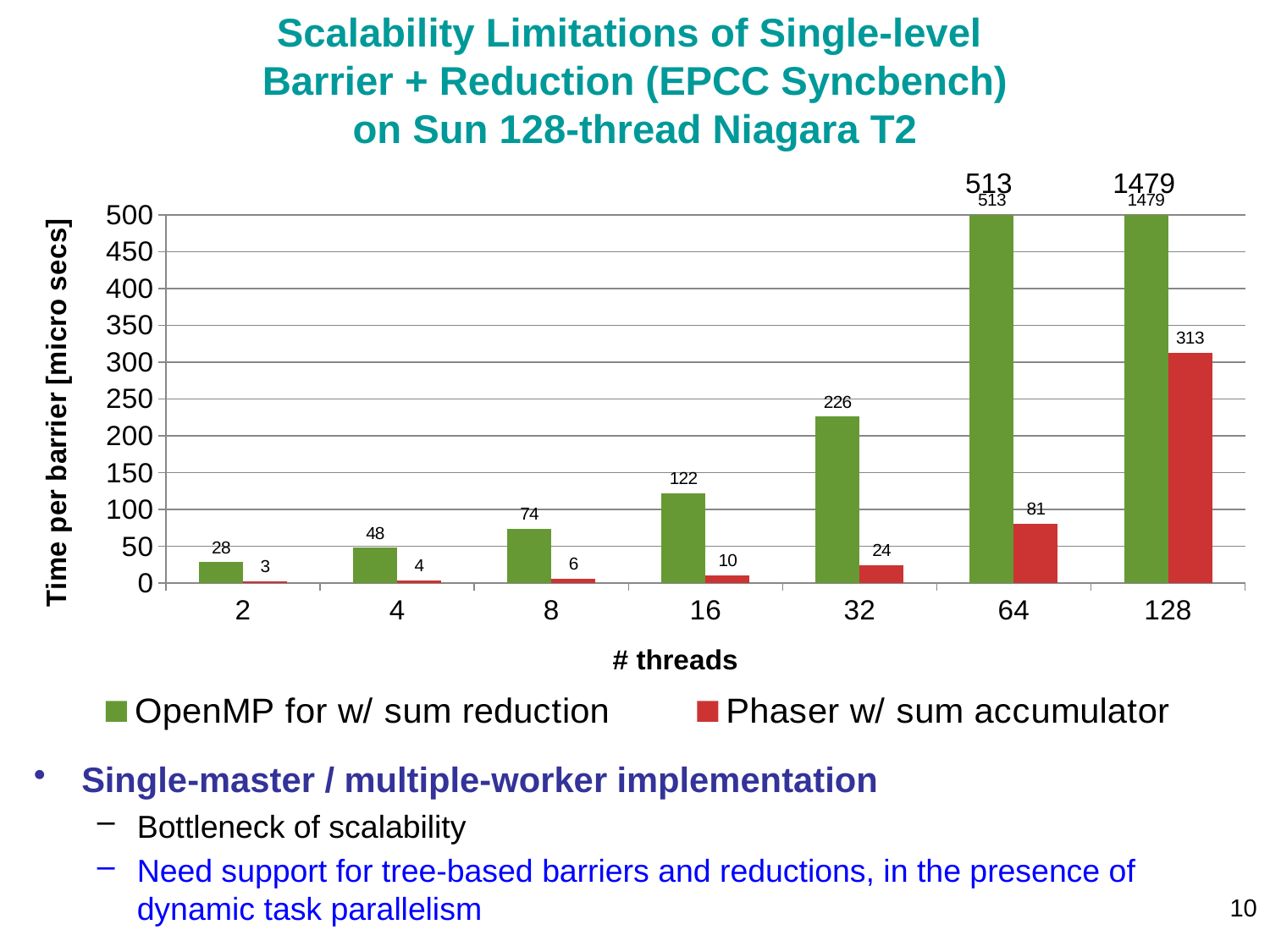
How many thread counts are shown on the x axis? 7 At which number of threads is the Phaser w/ sum accumulator value lowest? 2 What is the difference between the OpenMP for w/ sum reduction and Phaser w/ sum accumulator values at 64 threads? 432 Which is larger at 16 threads: OpenMP for w/ sum reduction or Phaser w/ sum accumulator? OpenMP for w/ sum reduction Do the OpenMP for w/ sum reduction values rise or fall as the number of threads increases? rise What is the value for OpenMP for w/ sum reduction at 32 threads? 226 What is the value for OpenMP for w/ sum reduction at 128 threads? 1479 How many series does the legend list? 2 At which number of threads is the OpenMP for w/ sum reduction value highest? 128 What is the value for Phaser w/ sum accumulator at 128 threads? 313 What kind of chart is shown on the slide? bar chart What is the value for Phaser w/ sum accumulator at 64 threads? 81